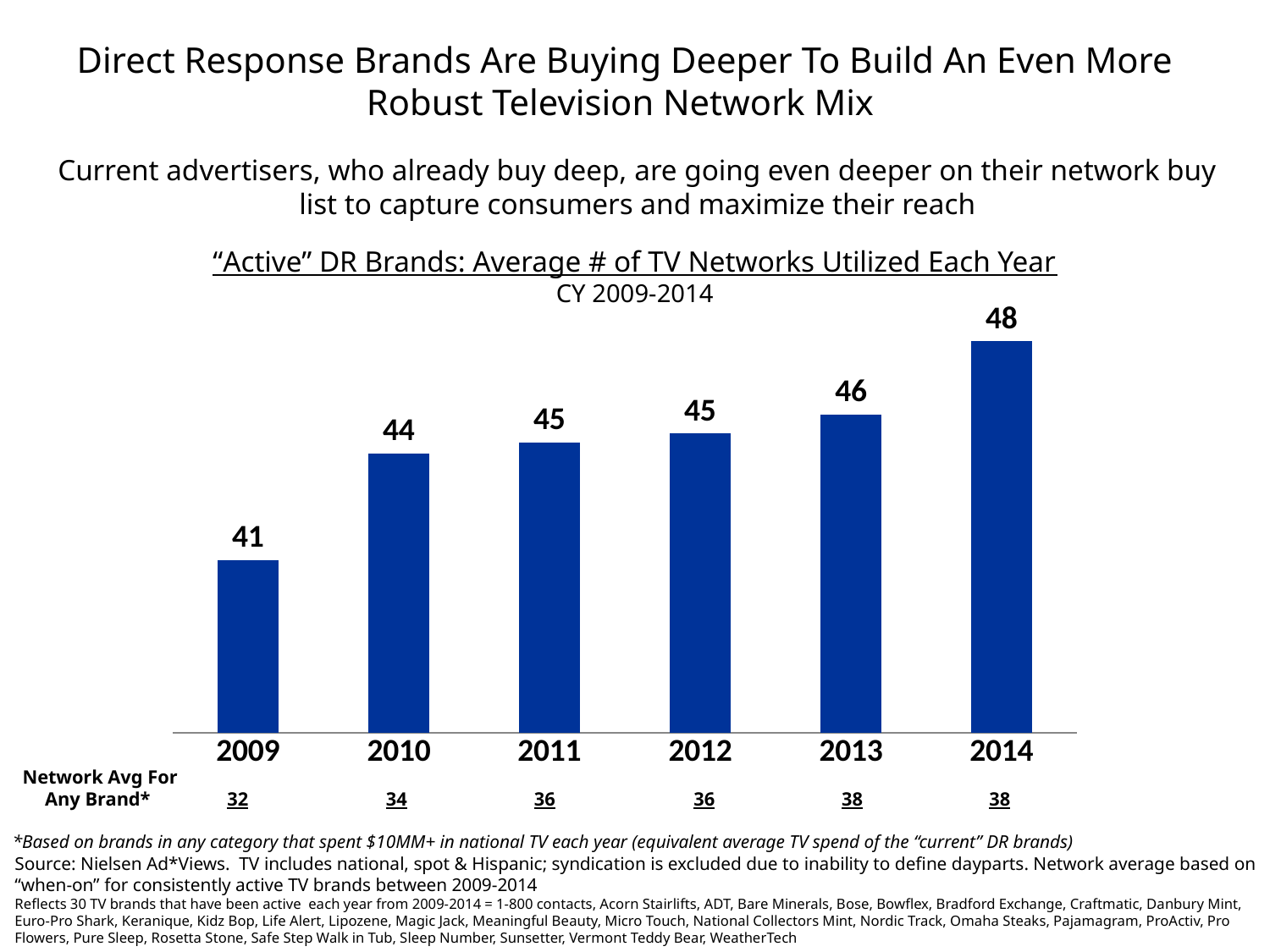
What is the difference between the 2014 value and the 2009 value? 7 Which year has a larger value, 2010 or 2013? 2013 What is the difference between the 2010 value and the 2013 value? 2 What is the Network Avg For Any Brand shown below the chart for 2012? 36 What is the value shown for 2011 in the chart? 45 How many years are shown on the x axis of the chart? 6 Do the values rise or fall from 2009 to 2014? Rise What kind of chart is shown on the slide? Bar chart What is the average number of TV networks utilized by "Active" DR brands in 2009? 41 Which year has the highest average number of TV networks utilized? 2014 What is the average number of TV networks utilized by "Active" DR brands in 2014? 48 Which year has the lowest average number of TV networks utilized? 2009